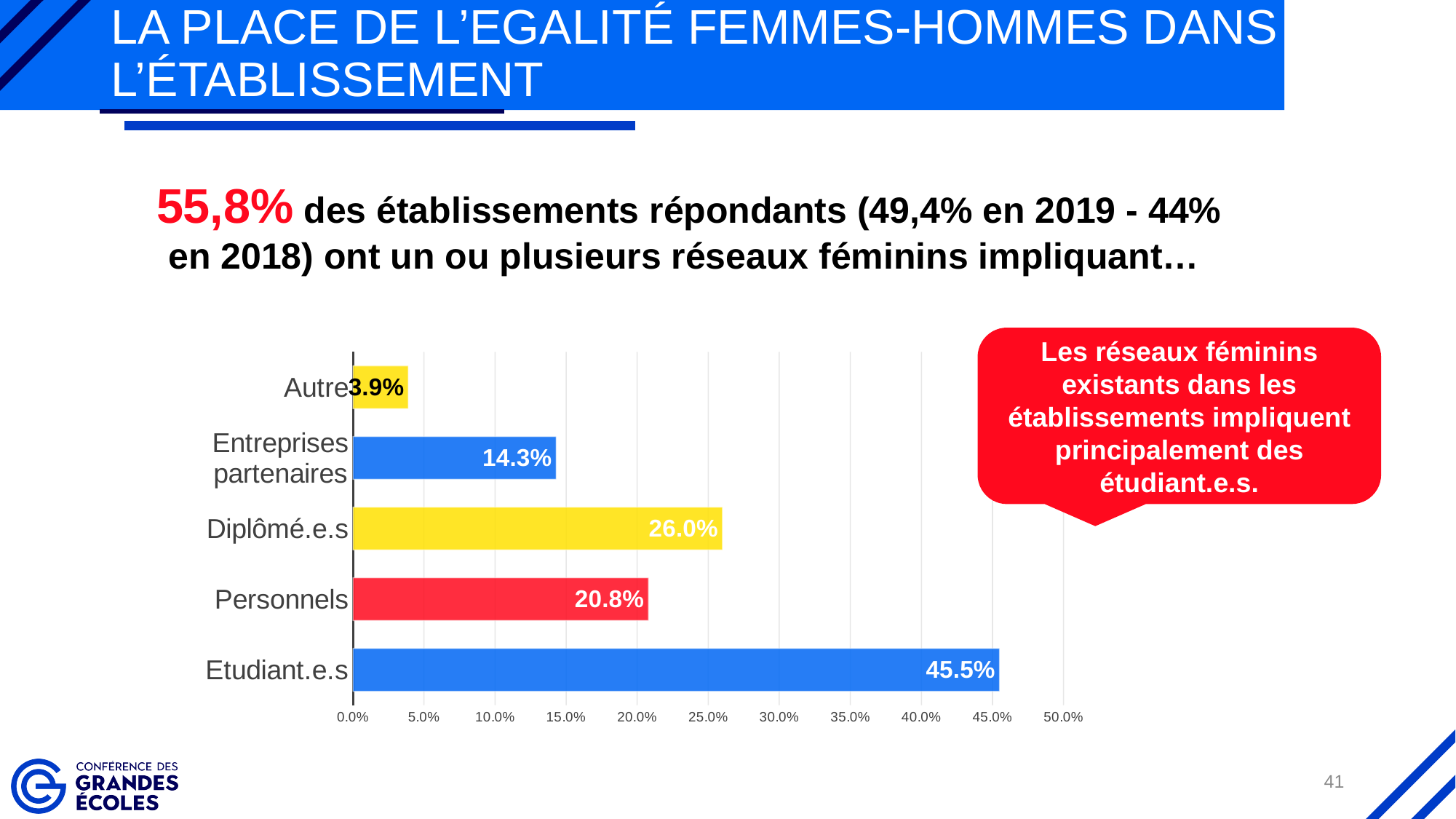
What colour is the bar for Personnels? red How many categories are shown in the chart? 5 Is the value for Diplômé.e.s greater or less than 25.0%? greater Which category has the lowest value? Autre What kind of chart is shown on the slide? bar chart What is the difference between the values for Etudiant.e.s and Diplômé.e.s? 19.5% Which is larger, the value for Personnels or the value for Entreprises partenaires? Personnels Which category has the highest value? Etudiant.e.s What is the value for Diplômé.e.s? 26.0% What is the value for Personnels? 20.8% What is the value for Etudiant.e.s? 45.5% What is the value for Entreprises partenaires? 14.3%